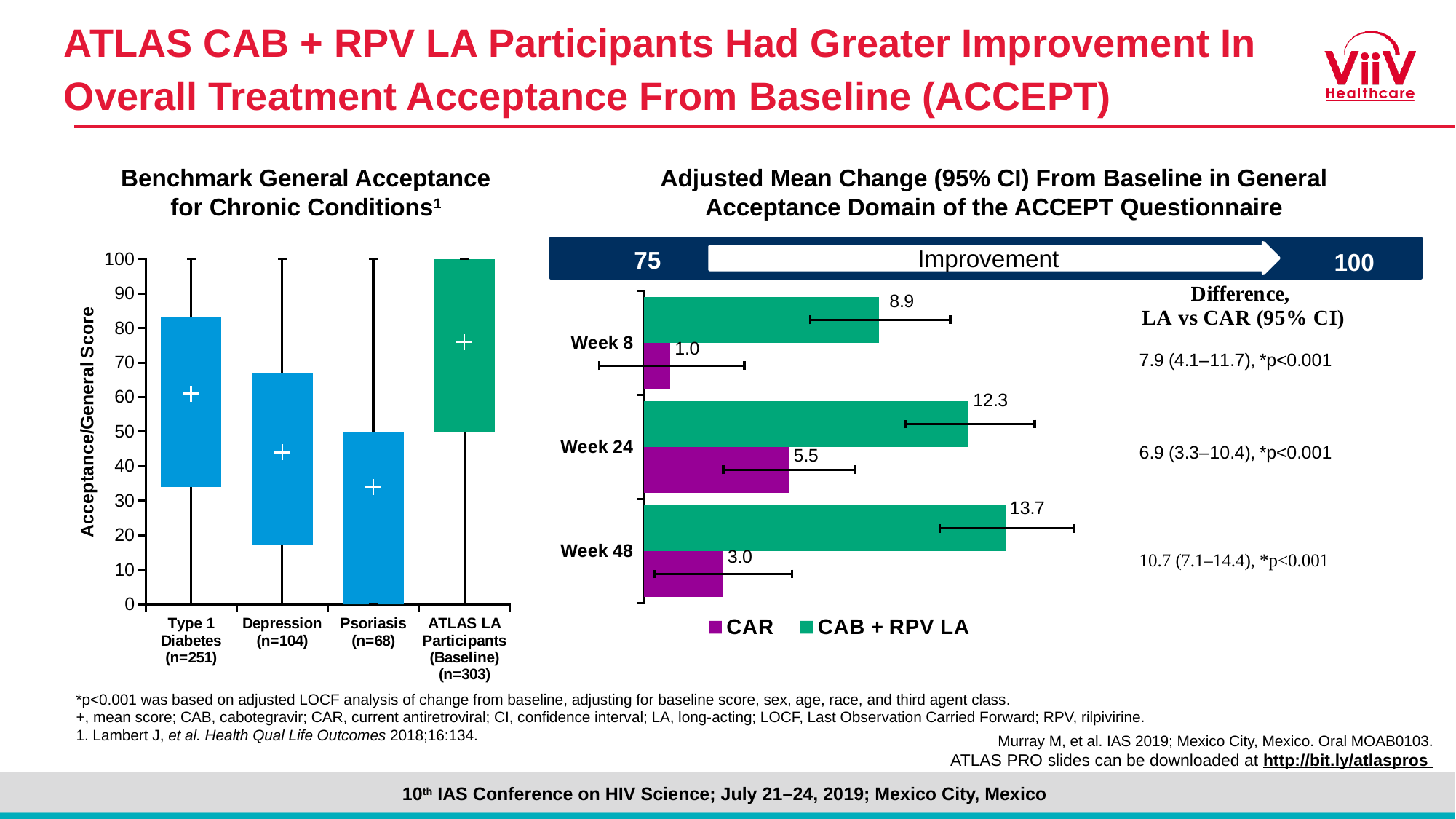
On the right chart, what is the adjusted mean change for CAR at Week 8? 1.0 On the right chart, at which week is the CAR value lowest? Week 8 How many categories are shown on the x axis of the left chart? 4 On the left chart, is the mean score for Psoriasis (n=68) greater or less than 40? less On the right chart, at which week is the CAB + RPV LA value highest? Week 48 On the right chart, what is the adjusted mean change for CAR at Week 24? 5.5 On the right chart, what is the adjusted mean change for CAB + RPV LA at Week 48? 13.7 What kind of chart is the right chart? Bar chart How many series does the legend of the right chart list? 2 On the right chart, what is the difference between the CAB + RPV LA and CAR values at Week 24? 6.8 On the right chart, do the CAB + RPV LA values rise or fall from Week 8 to Week 48? Rise On the right chart, which is larger at Week 48: the CAR value or the CAB + RPV LA value? CAB + RPV LA